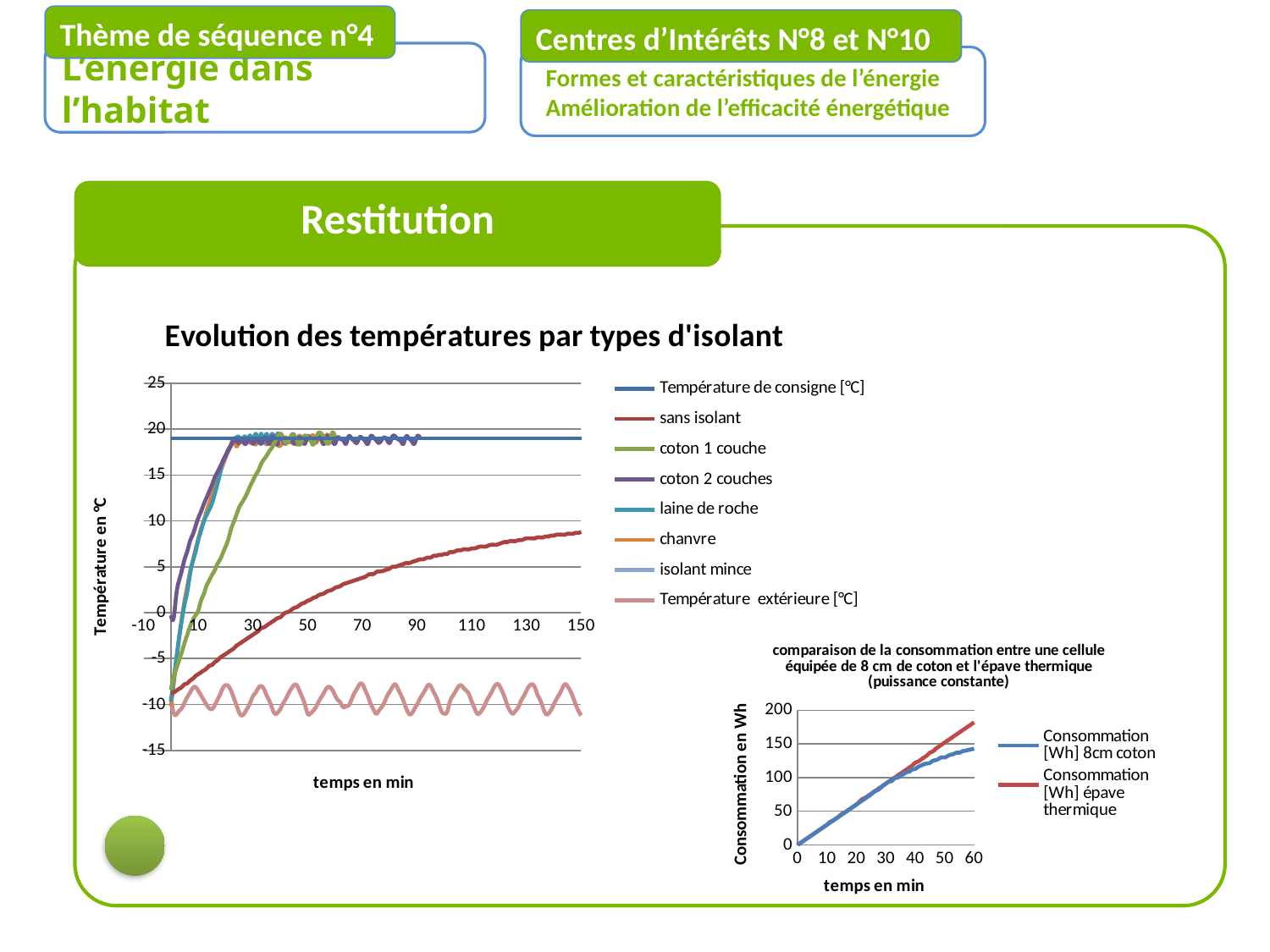
What kind of chart is 'Evolution des températures par types d'isolant'? line chart What is the y-axis label of the 'comparaison de la consommation' chart? Consommation en Wh In the 'comparaison de la consommation' chart, which series is larger at 60 min: 'Consommation [Wh] 8cm coton' or 'Consommation [Wh] épave thermique'? Consommation [Wh] épave thermique What is the x-axis label of 'Evolution des températures par types d'isolant'? temps en min In 'Evolution des températures par types d'isolant', is the 'Température de consigne [°C]' line greater or less than 15? greater How many series does the legend of 'Evolution des températures par types d'isolant' list? 8 How many series does the legend of the 'comparaison de la consommation' chart list? 2 In 'Evolution des températures par types d'isolant', is the value of 'sans isolant' at 150 min greater or less than 10? less In the 'comparaison de la consommation' chart, is the value of 'Consommation [Wh] 8cm coton' at 60 min greater or less than 100? greater In 'Evolution des températures par types d'isolant', does the 'sans isolant' series rise or fall along the x axis? rise